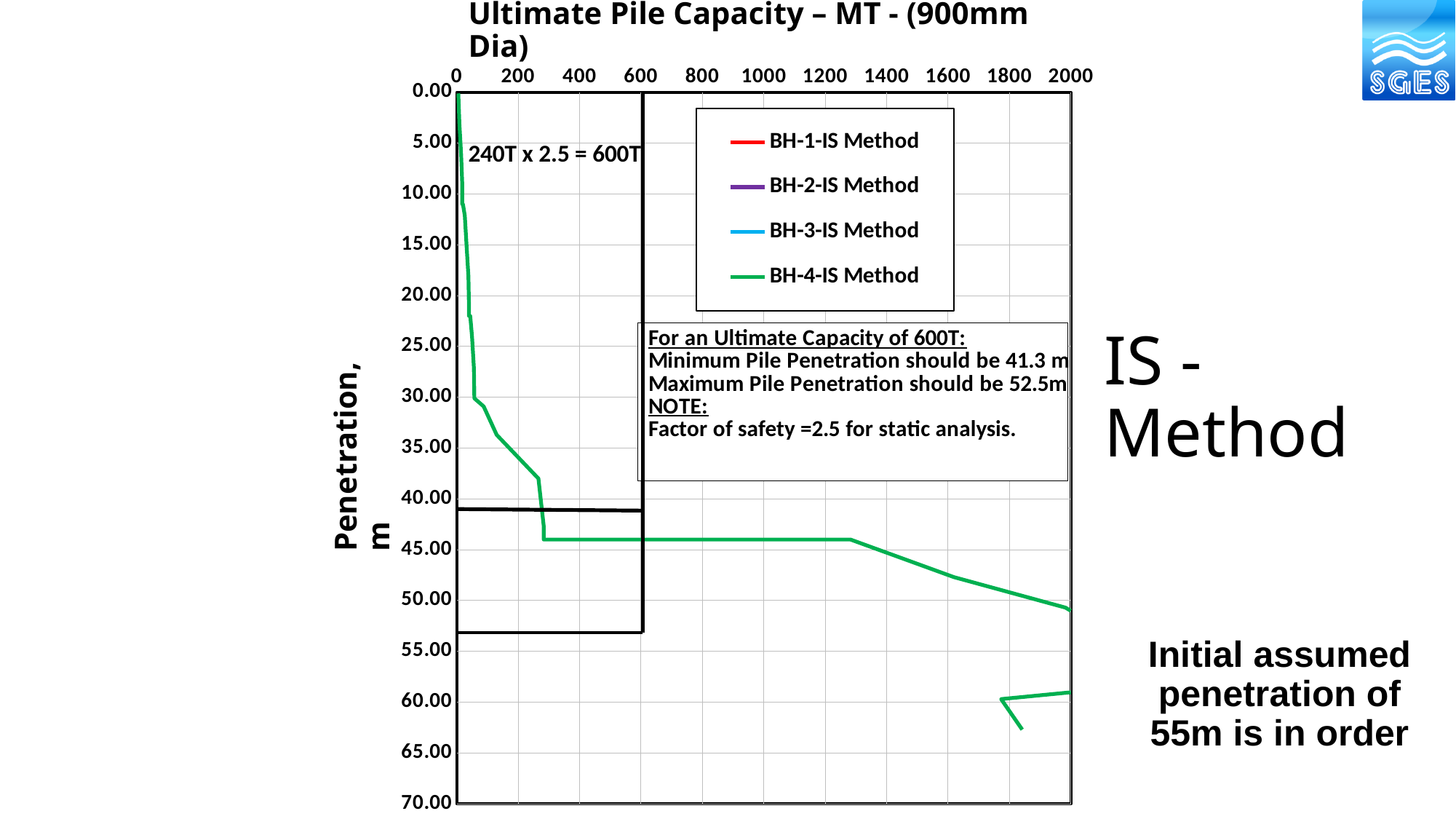
According to the annotation on the chart, what is the maximum pile penetration for an ultimate capacity of 600T? 52.5m According to the note on the chart, what factor of safety is used for static analysis? 2.5 Does the ultimate pile capacity of the BH-4-IS Method line increase or decrease as penetration increases from 0.00 m to 50.00 m? increase Is the ultimate pile capacity of the BH-4-IS Method line at a penetration of 40.00 m greater or less than 400? less According to the annotation on the chart, what is the minimum pile penetration for an ultimate capacity of 600T? 41.3 m What kind of chart is shown on the slide? line chart What colour is the BH-4-IS Method line in the legend? green Is the ultimate pile capacity of the BH-4-IS Method line at a penetration of 20.00 m greater or less than 200? less What is the title of the chart? Ultimate Pile Capacity – MT - (900mm Dia) Is the ultimate pile capacity of the BH-4-IS Method line at a penetration of 30.00 m greater or less than 200? less How many series does the legend list? 4